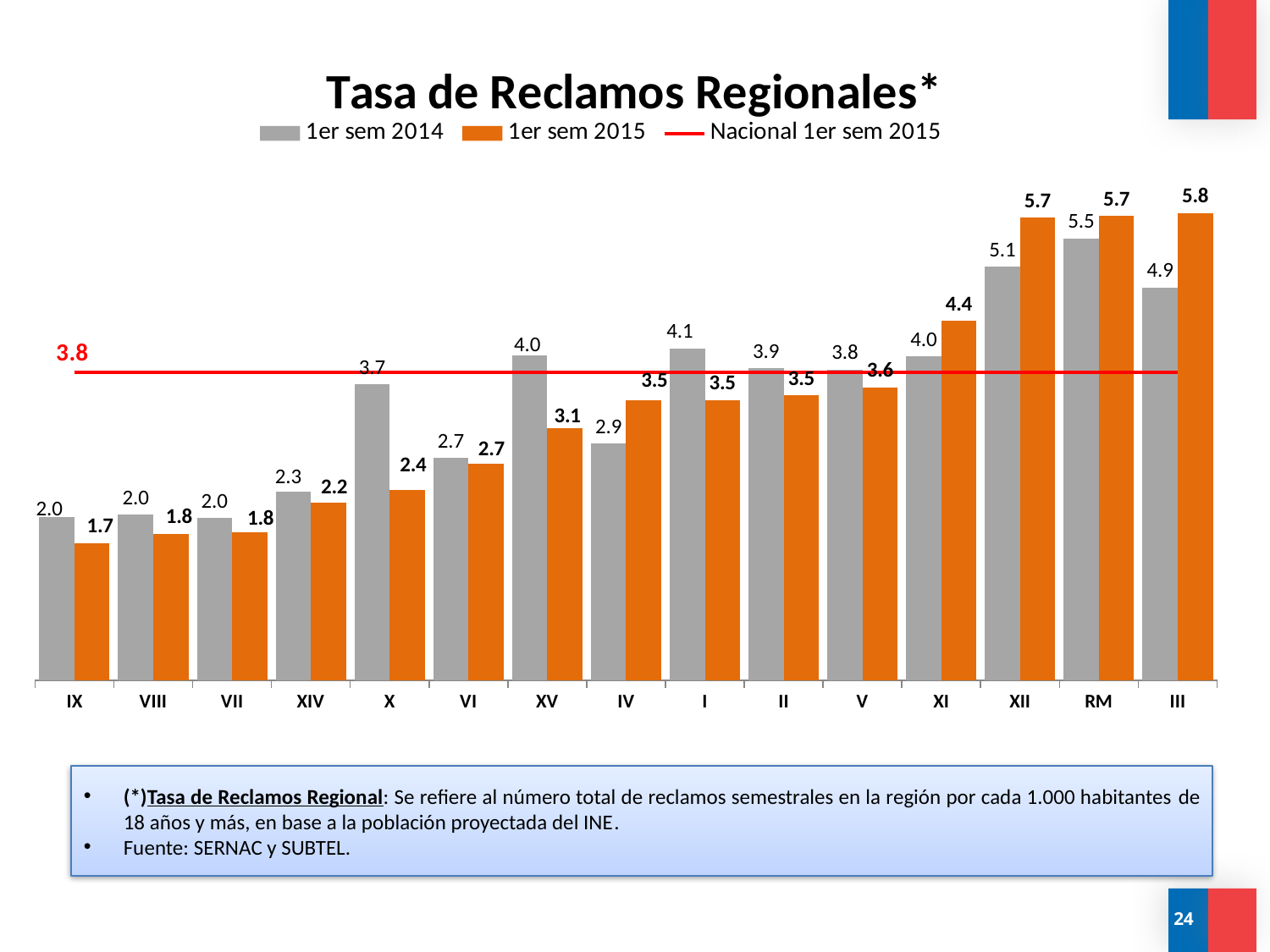
Which region has the lowest value in the 1er sem 2015 series? IX What is the value for region XI in the 1er sem 2015 series? 4.4 What is the value for region X in the 1er sem 2014 series? 3.7 For region XV, which is larger: the 1er sem 2014 value or the 1er sem 2015 value? 1er sem 2014 Which region has the highest value in the 1er sem 2014 series? RM What kind of chart is shown on the slide? Bar chart Which region has the highest value in the 1er sem 2015 series? III By how much did the value for region III increase from 1er sem 2014 to 1er sem 2015? 0.9 How many series does the legend list? 3 What is the difference between the 1er sem 2014 and 1er sem 2015 values for region X? 1.3 How many regions are shown on the x axis of the chart? 15 What value does the Nacional 1er sem 2015 line mark? 3.8